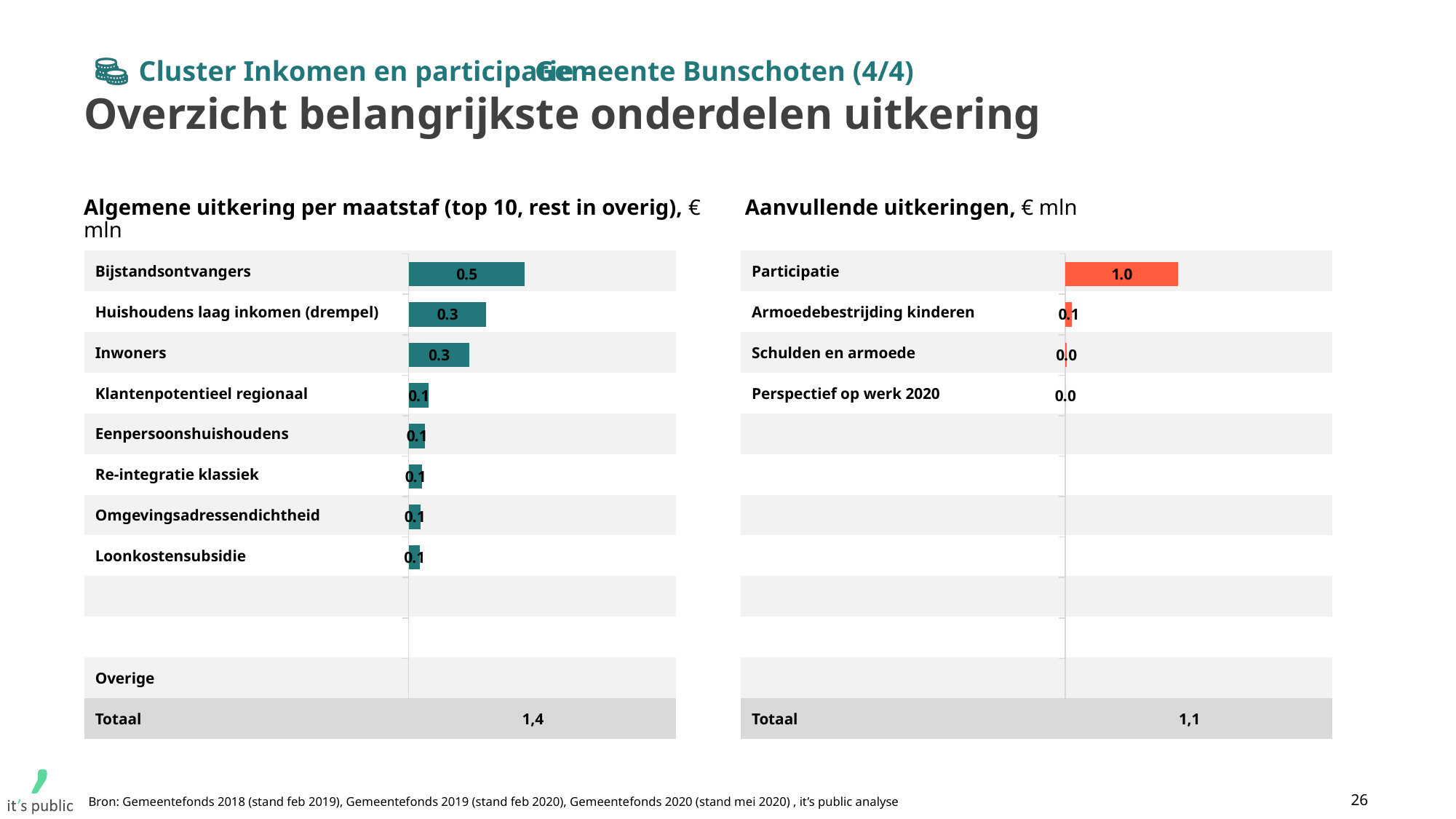
In the right chart 'Aanvullende uitkeringen', how many labeled categories are shown? 4 In the left chart 'Algemene uitkering per maatstaf', what is the difference between Bijstandsontvangers and Huishoudens laag inkomen (drempel)? 0.2 In the right chart 'Aanvullende uitkeringen', which category has the highest value? Participatie In the left chart 'Algemene uitkering per maatstaf', how many categories have a plotted bar? 8 What kind of chart is the left chart 'Algemene uitkering per maatstaf'? Bar chart In the left chart 'Algemene uitkering per maatstaf', what is the value for Bijstandsontvangers? 0.5 In the left chart 'Algemene uitkering per maatstaf', what is the value for Inwoners? 0.3 In the right chart 'Aanvullende uitkeringen', which is larger: Participatie or Armoedebestrijding kinderen? Participatie In the left chart 'Algemene uitkering per maatstaf', which category has the highest value? Bijstandsontvangers In the right chart 'Aanvullende uitkeringen', what is the value for Participatie? 1.0 In the right chart 'Aanvullende uitkeringen', what is the value for Armoedebestrijding kinderen? 0.1 What total is shown in the 'Totaal' row of the right chart 'Aanvullende uitkeringen'? 1,1